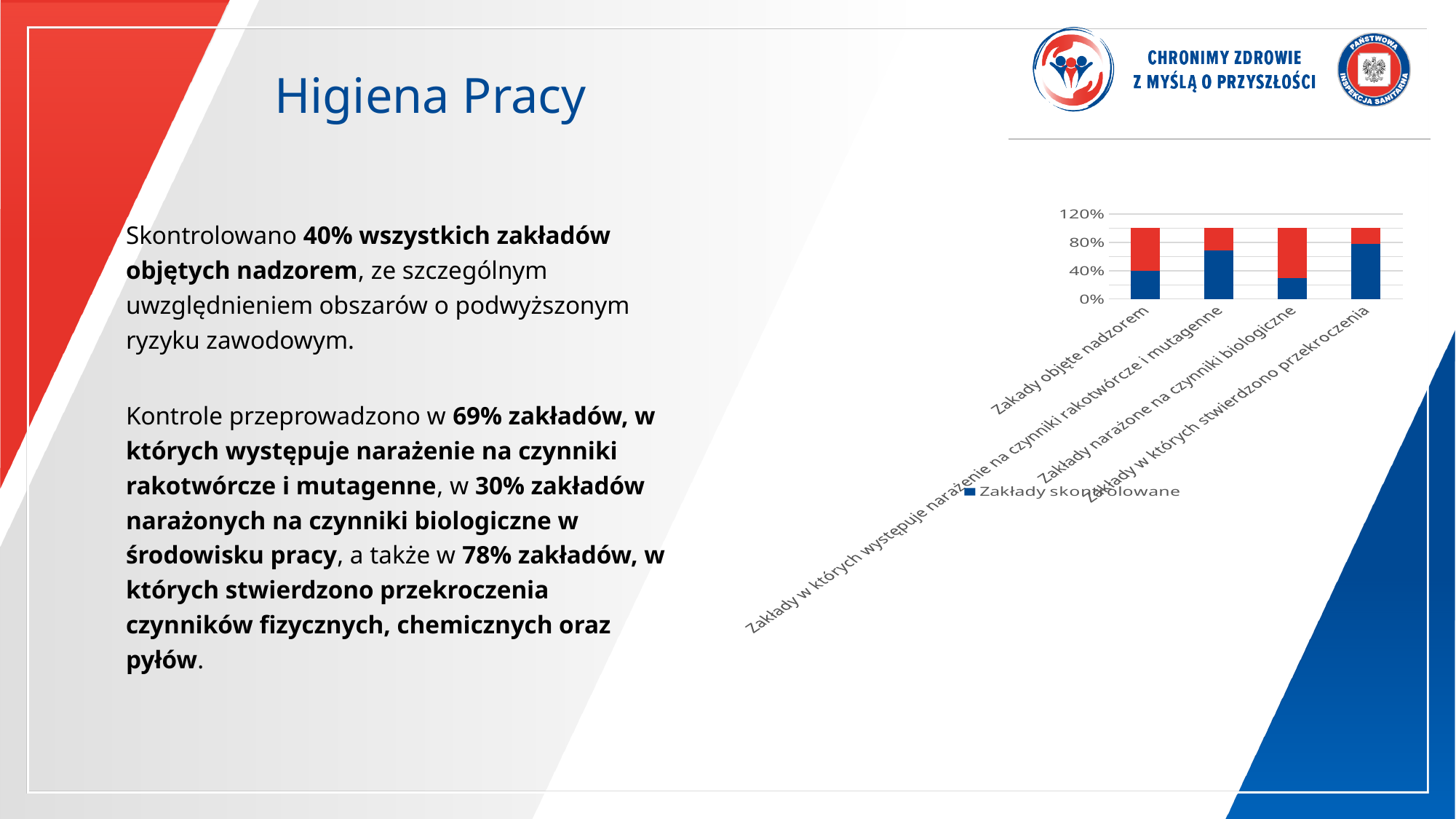
Which category has the lowest value for the series Zakłady skontrolowane? Zakłady narażone na czynniki biologiczne Is the Zakłady skontrolowane value for Zakłady narażone na czynniki biologiczne greater or less than 40%? less Which category has the highest value for the series Zakłady skontrolowane? Zakłady w których stwierdzono przekroczenia How many categories are shown on the x axis of the chart? 4 Which has the larger Zakłady skontrolowane value: Zakłady w których występuje narażenie na czynniki rakotwórcze i mutagenne or Zakłady narażone na czynniki biologiczne? Zakłady w których występuje narażenie na czynniki rakotwórcze i mutagenne What colour represents the series Zakłady skontrolowane in the chart? blue Is the Zakłady skontrolowane value for Zakłady w których występuje narażenie na czynniki rakotwórcze i mutagenne greater or less than 40%? greater Is the Zakłady skontrolowane value for Zakłady w których stwierdzono przekroczenia greater or less than 40%? greater What series name is shown in the chart legend? Zakłady skontrolowane What kind of chart is shown on the slide? bar chart What is the Zakłady skontrolowane value for Zakłady objęte nadzorem? 40%